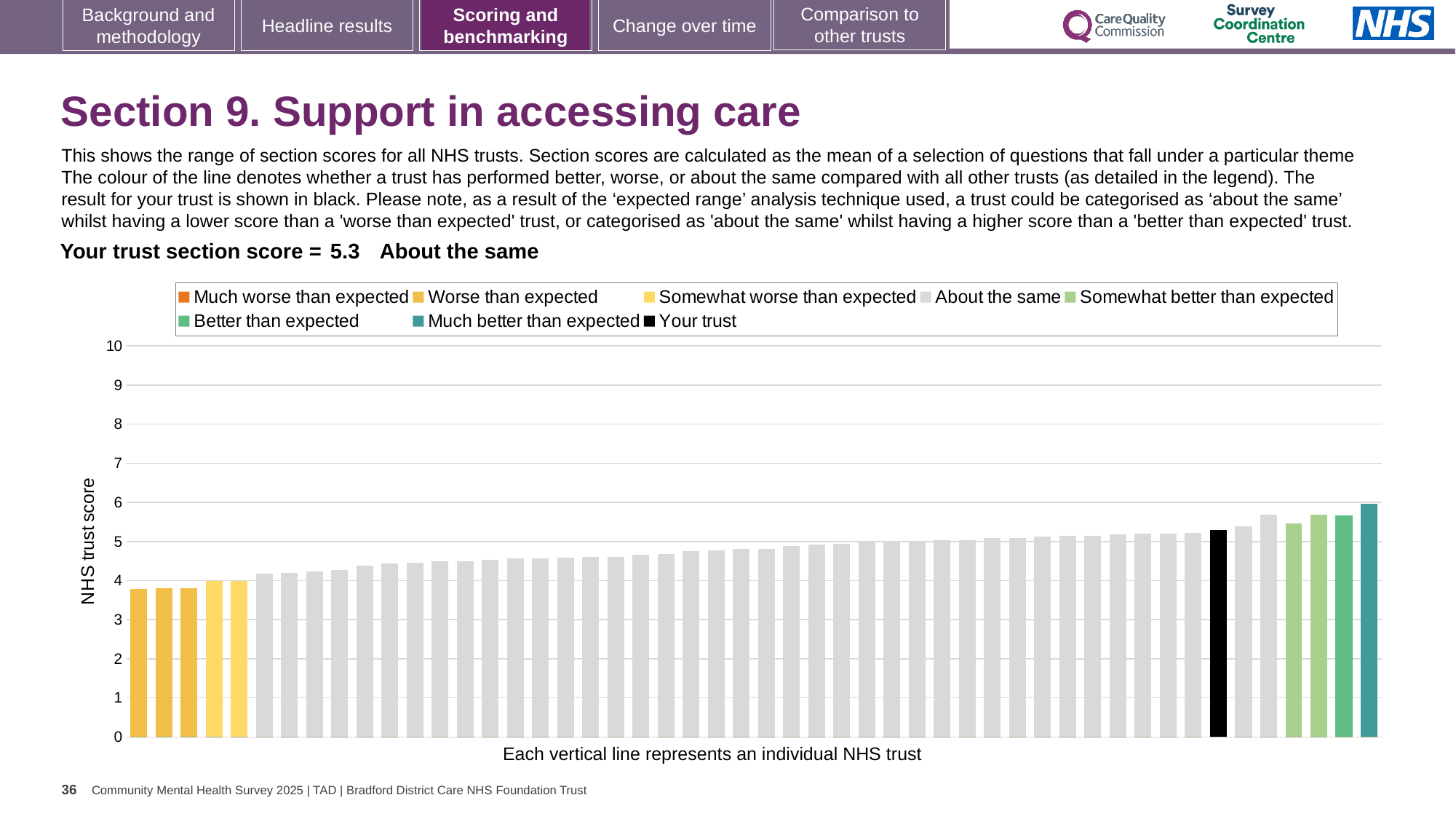
Which legend category does the highest bar belong to? Much better than expected Which legend category does the lowest bar belong to? Worse than expected What kind of chart is shown on the slide? bar chart Is the score for your trust (the black bar) greater or less than 6? less What is the section score for your trust shown on the slide? 5.3 Which performance category is your trust placed in? About the same What is the label on the y axis of the chart? NHS trust score Is the score of the leftmost bar greater or less than 5? less Is the score for your trust (the black bar) greater or less than 5? greater How many categories does the chart legend list? 8 What colour is the bar representing your trust? black Do the bar values rise or fall from left to right along the x axis? rise